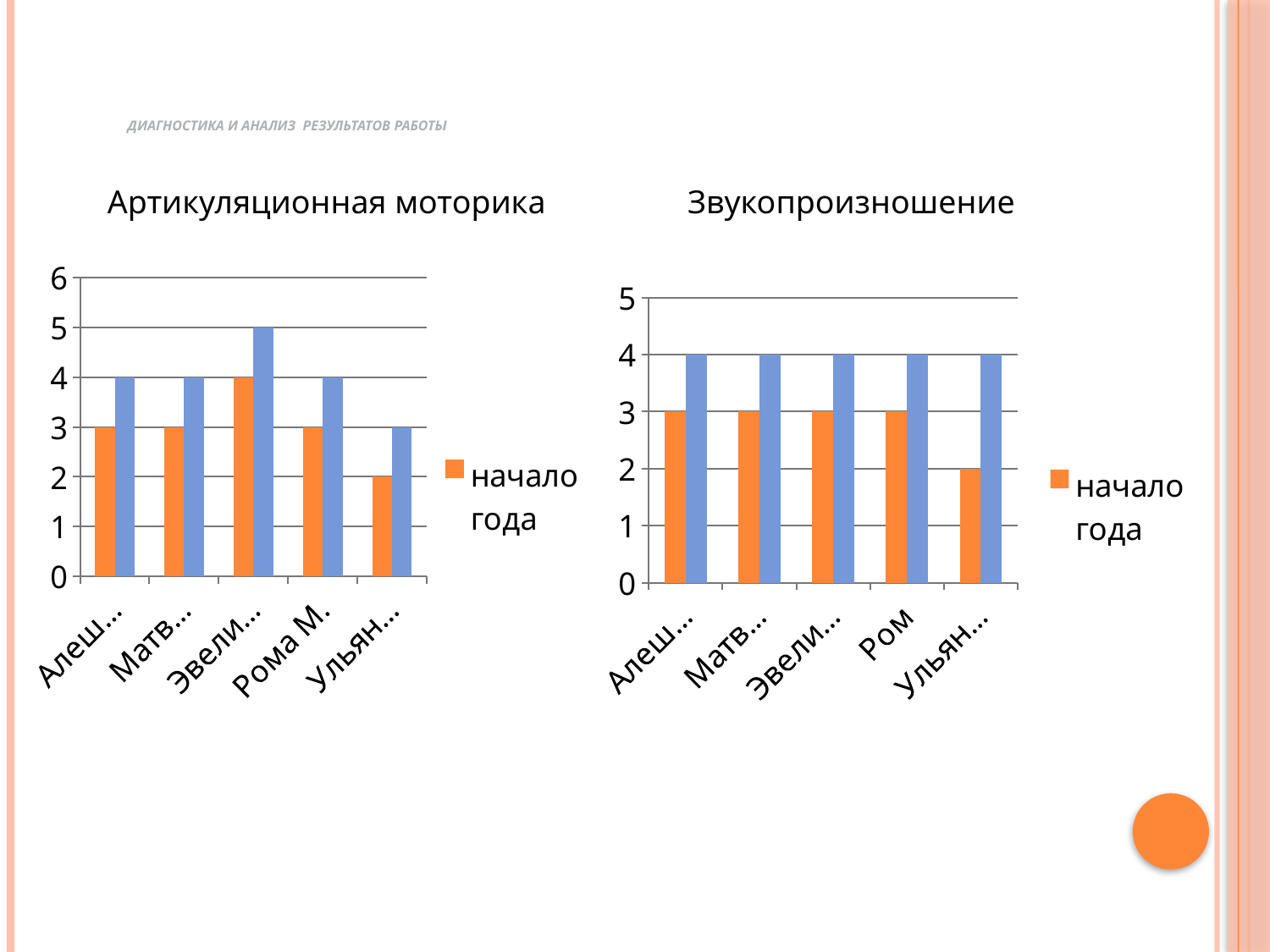
In the chart titled "Артикуляционная моторика", which category has the highest blue bar? Эвели... (the third category) In the chart titled "Артикуляционная моторика", what is the value of the blue bar for Рома М.? 4 In the chart titled "Звукопроизношение", what is the value of the orange bar for Ром? 3 What kind of chart is the chart titled "Звукопроизношение"? Bar chart In the chart titled "Звукопроизношение", what is the value of the blue bar for Ром? 4 In the chart titled "Артикуляционная моторика", what is the value of the orange bar for Рома М.? 3 In the chart titled "Звукопроизношение", which category has the lowest orange bar? Ульян... (the last category) In the chart titled "Артикуляционная моторика", what is the value of the tallest bar? 5 In the chart titled "Звукопроизношение", what is the difference between the blue bar and the orange bar for Ром? 1 In the chart titled "Артикуляционная моторика", how many categories are shown on the x axis? 5 In the chart titled "Артикуляционная моторика", what is the value of the orange bar for the last category (Ульян...)? 2 In the chart titled "Звукопроизношение", what is the legend entry shown? начало года